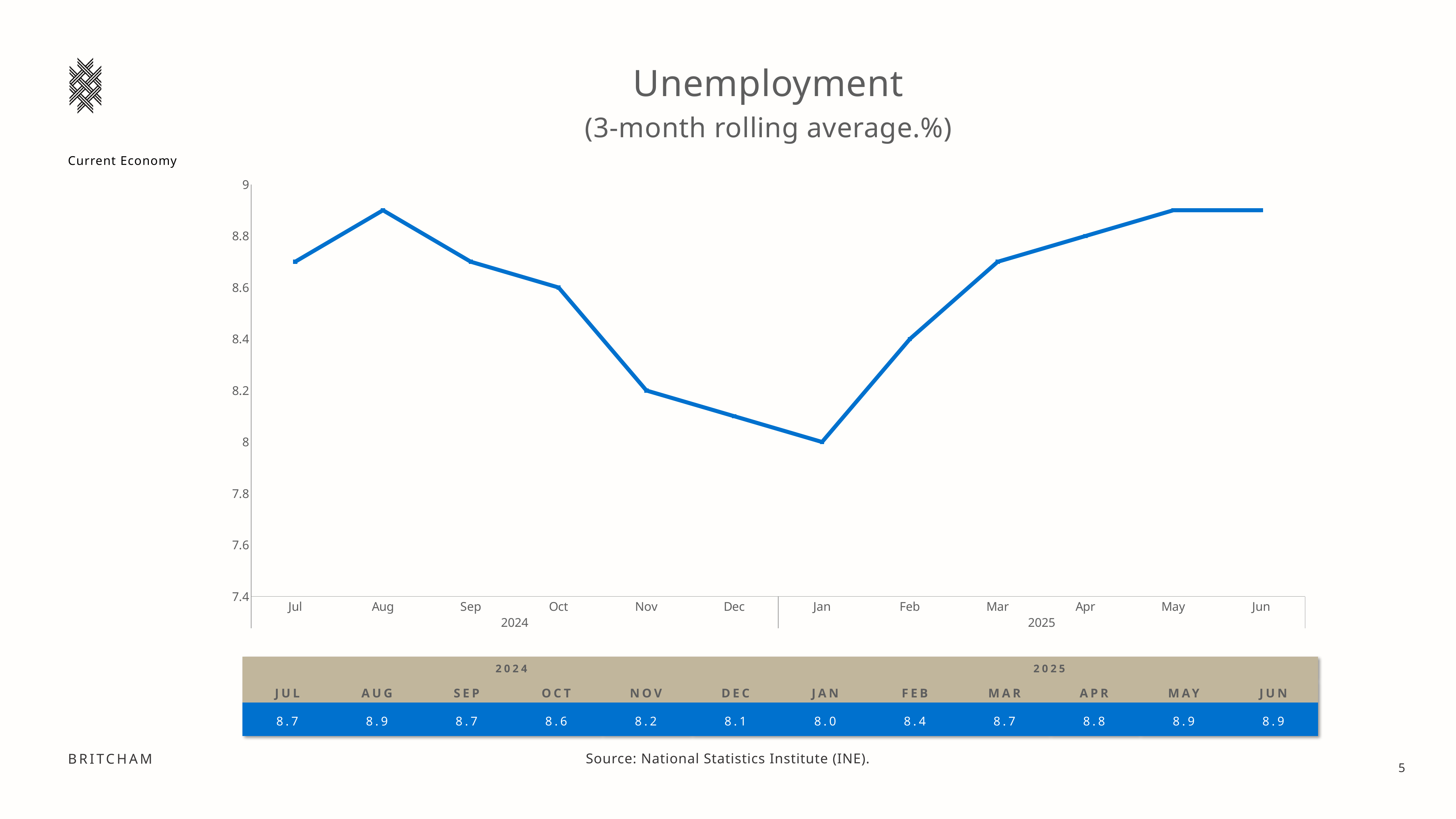
What is the unemployment value for Jan 2025? 8.0 What is the unemployment value for Apr 2025? 8.8 What is the highest unemployment value shown? 8.9 What is the difference between the unemployment values for Feb 2025 and Mar 2025? 0.3 What is the unemployment value for Nov 2024? 8.2 What is the difference between the unemployment values for Aug 2024 and Jan 2025? 0.9 Which is larger, the unemployment value for Oct 2024 or for Feb 2025? Oct 2024 Do the unemployment values rise or fall from Jan 2025 to May 2025? rise How many monthly data points are plotted on the chart? 12 Which month has the lowest unemployment value? Jan 2025 What kind of chart is shown on the slide? line chart Is the unemployment value for Dec 2024 greater or less than 8.4? less